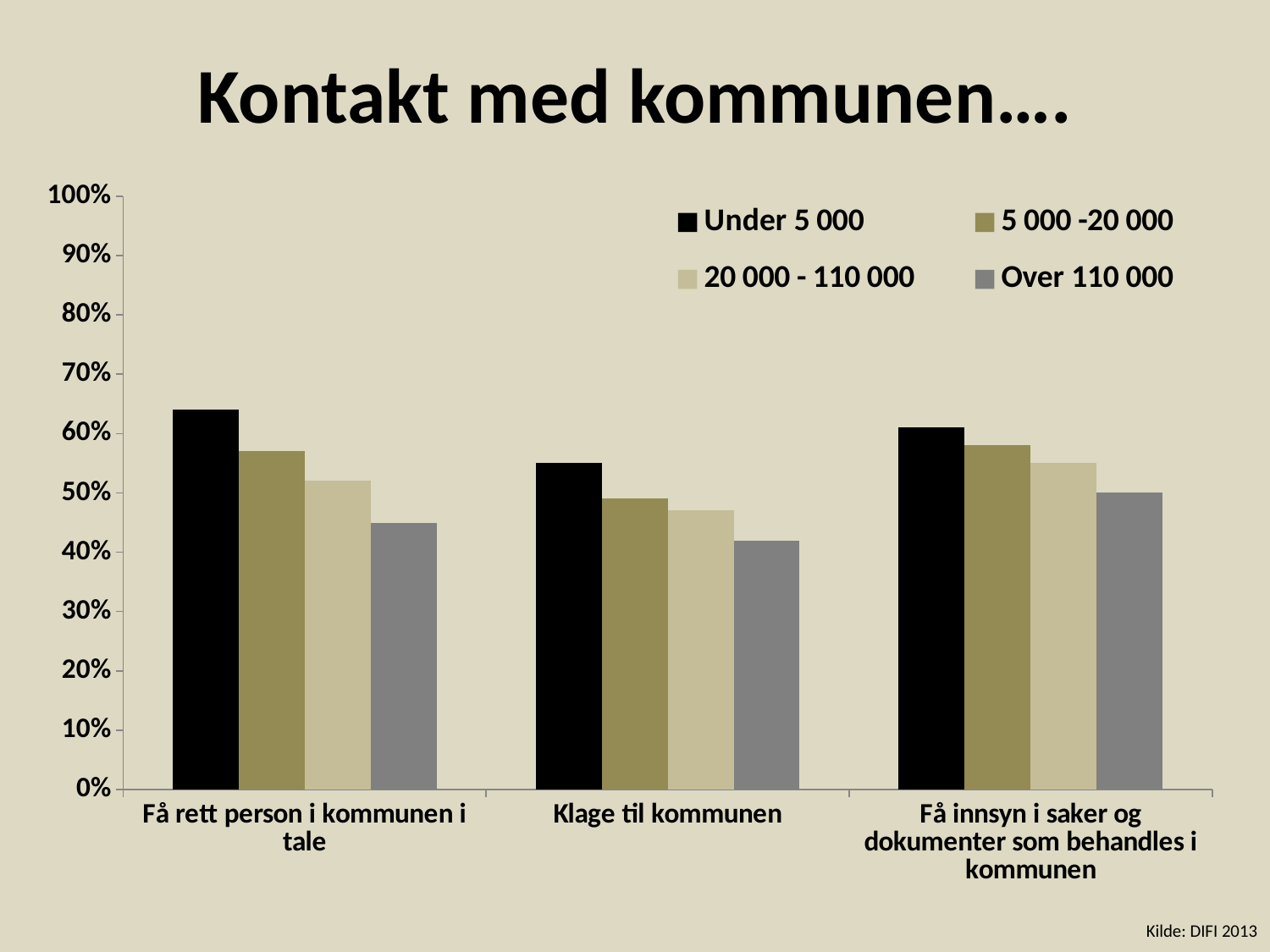
Is the value for Under 5 000 in the category 'Få rett person i kommunen i tale' greater or less than 60%? greater Is the value for 20 000 - 110 000 in the category 'Få innsyn i saker og dokumenter som behandles i kommunen' greater or less than 50%? greater Is the value for Over 110 000 in the category 'Få rett person i kommunen i tale' greater or less than 50%? less Which series has the highest value in the category 'Få rett person i kommunen i tale'? Under 5 000 What is the title of the chart? Kontakt med kommunen…. How many series does the legend list? 4 What kind of chart is shown on the slide? Bar chart Which series has the lowest value in the category 'Klage til kommunen'? Over 110 000 How many categories are shown on the x axis? 3 For the series Under 5 000, which is larger: the value for 'Få rett person i kommunen i tale' or the value for 'Klage til kommunen'? Få rett person i kommunen i tale